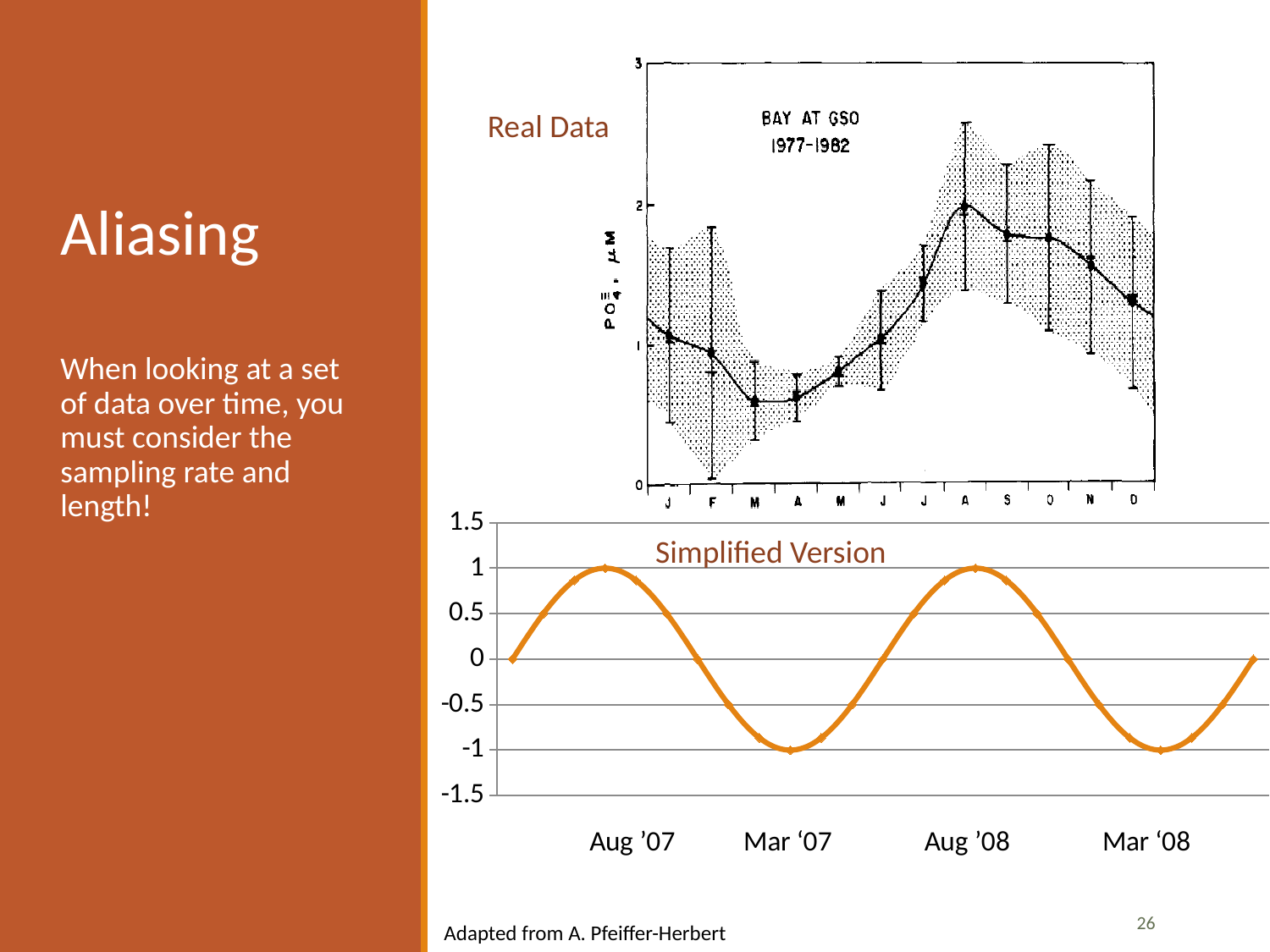
In the "Simplified Version" chart, what is the highest value shown on the y axis? 1.5 In the "Simplified Version" chart, what is the value at Aug '08? 1 In the "Simplified Version" chart, what is the value at Aug '07? 1 In the "Simplified Version" chart, what is the value at Mar '07? -1 In the "Simplified Version" chart, how many labels are shown on the x axis? 4 In the "Real Data" chart, how many months are marked along the x axis? 12 What kind of chart is the "Real Data" chart? line chart In the "Real Data" chart, is the value for the month labelled M (March) greater or less than 1? less In the "Simplified Version" chart, what is the difference between the value at Aug '08 and the value at Mar '08? 2 In the "Simplified Version" chart, which is larger, the value at Aug '07 or the value at Mar '08? Aug '07 In the "Real Data" chart, is the value for the month labelled A (August) greater or less than 1.5? greater What kind of chart is the "Simplified Version" chart? line chart